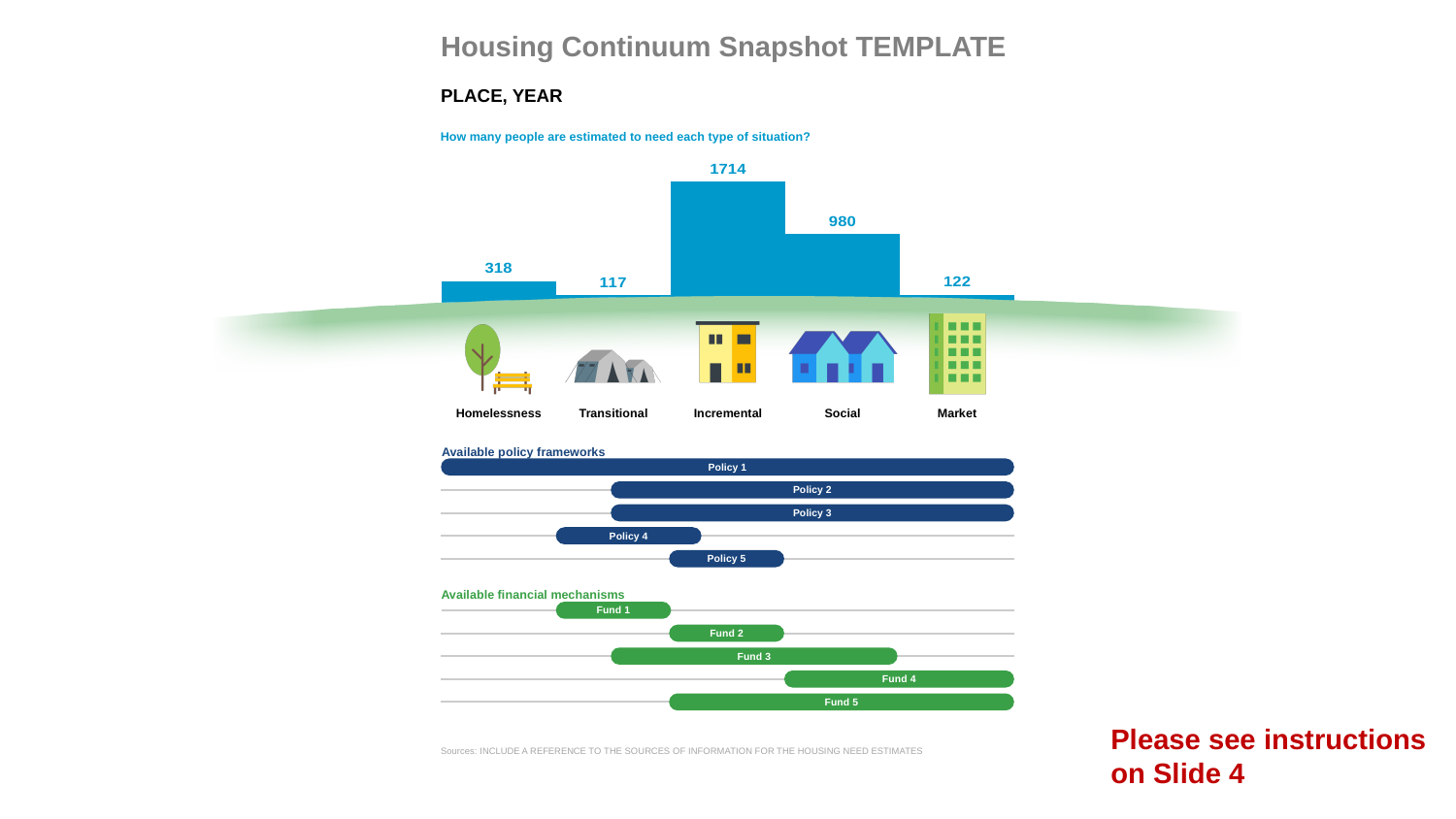
What is the estimated number of people needing Social housing? 980 What is the estimated number of people needing Incremental housing? 1714 How many housing categories are shown in the bar chart? 5 Which is larger, the value for Market or the value for Transitional? Market What is the value shown for Transitional? 117 What is the value shown for Homelessness? 318 What question does the chart's heading ask? How many people are estimated to need each type of situation? Which housing category has the highest estimated need? Incremental Which housing category has the lowest estimated need? Transitional What is the difference between the values for Incremental and Social? 734 What type of chart is used to show the estimated housing need? Bar chart What is the difference between the values for Homelessness and Market? 196